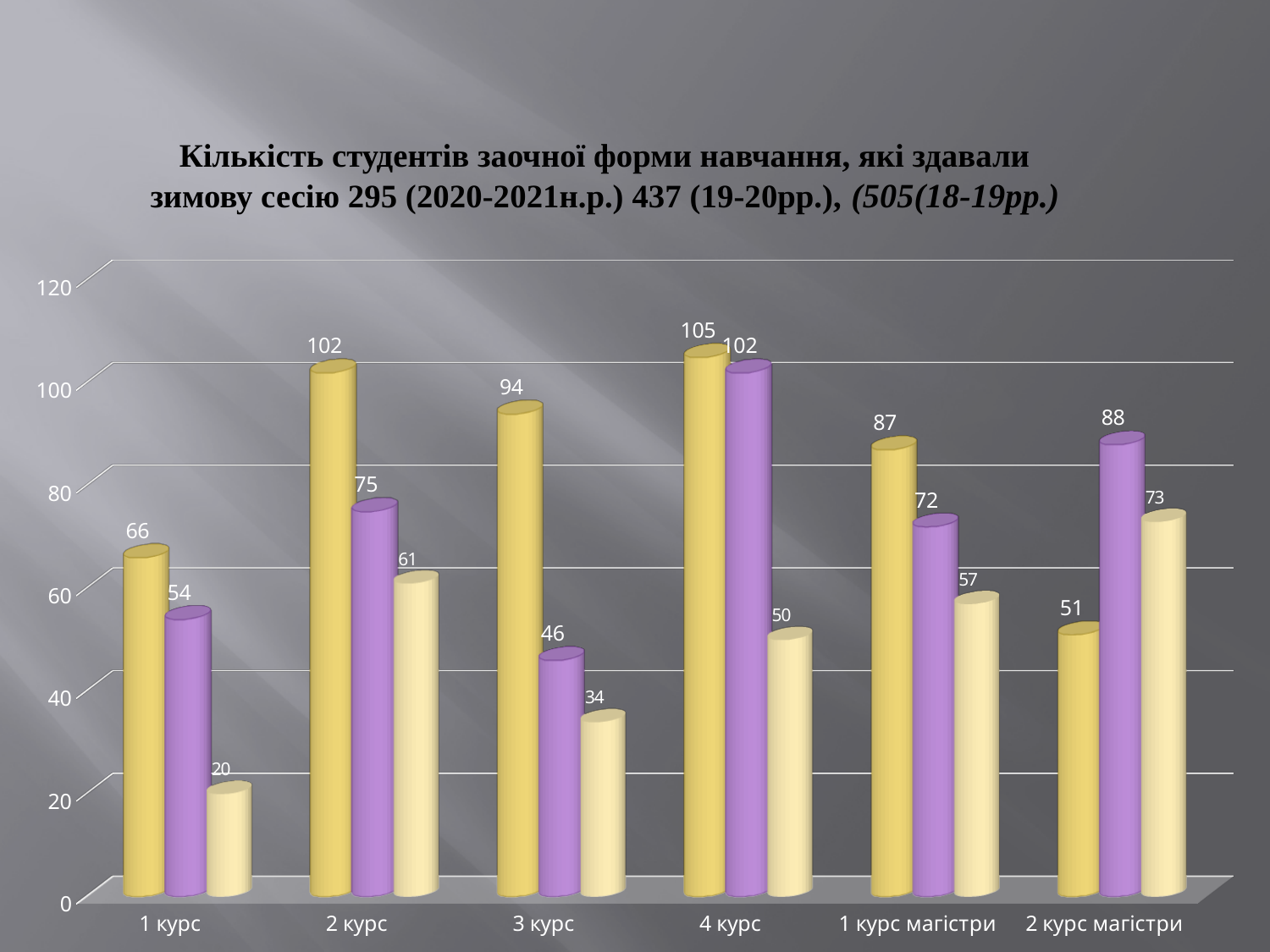
What is the value of the light yellow bar for 1 курс? 20 Which category has the lowest light yellow bar? 1 курс How many bars are shown for each category on the chart? 3 What type of chart is shown on the slide? bar chart For 2 курс магістри, which is larger: the gold bar or the purple bar? the purple bar What is the value of the gold bar for 2 курс? 102 What is the difference between the gold bar for 3 курс and the light yellow bar for 3 курс? 60 Is the value of the purple bar for 4 курс greater or less than 100? greater How many categories are shown on the x axis of the chart? 6 What is the difference between the gold bar and the purple bar for 1 курс магістри? 15 What is the value of the purple bar for 3 курс? 46 Which category has the highest gold bar? 4 курс